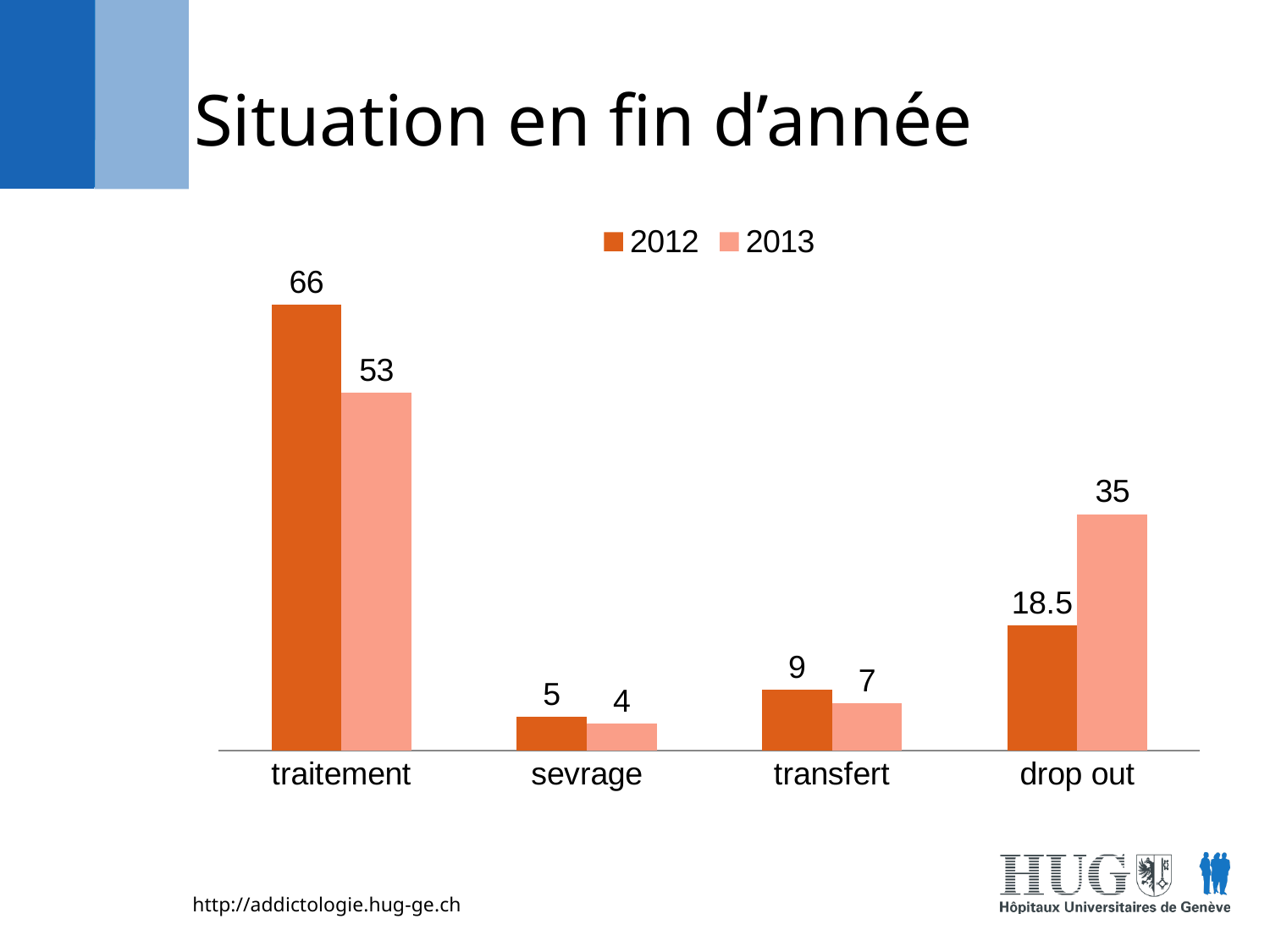
What is the difference between the 2013 and 2012 values for drop out? 16.5 How many series does the legend list? 2 What is the difference between the 2012 and 2013 values for traitement? 13 What is the value for drop out in 2012? 18.5 Which category has the lowest value for 2012? sevrage What is the value for traitement in 2012? 66 What is the value for drop out in 2013? 35 What is the value for transfert in 2013? 7 Which category has the highest value for 2013? traitement Which is larger for sevrage, the 2012 value or the 2013 value? 2012 What kind of chart is shown on the slide? bar chart How many categories are shown on the x axis? 4